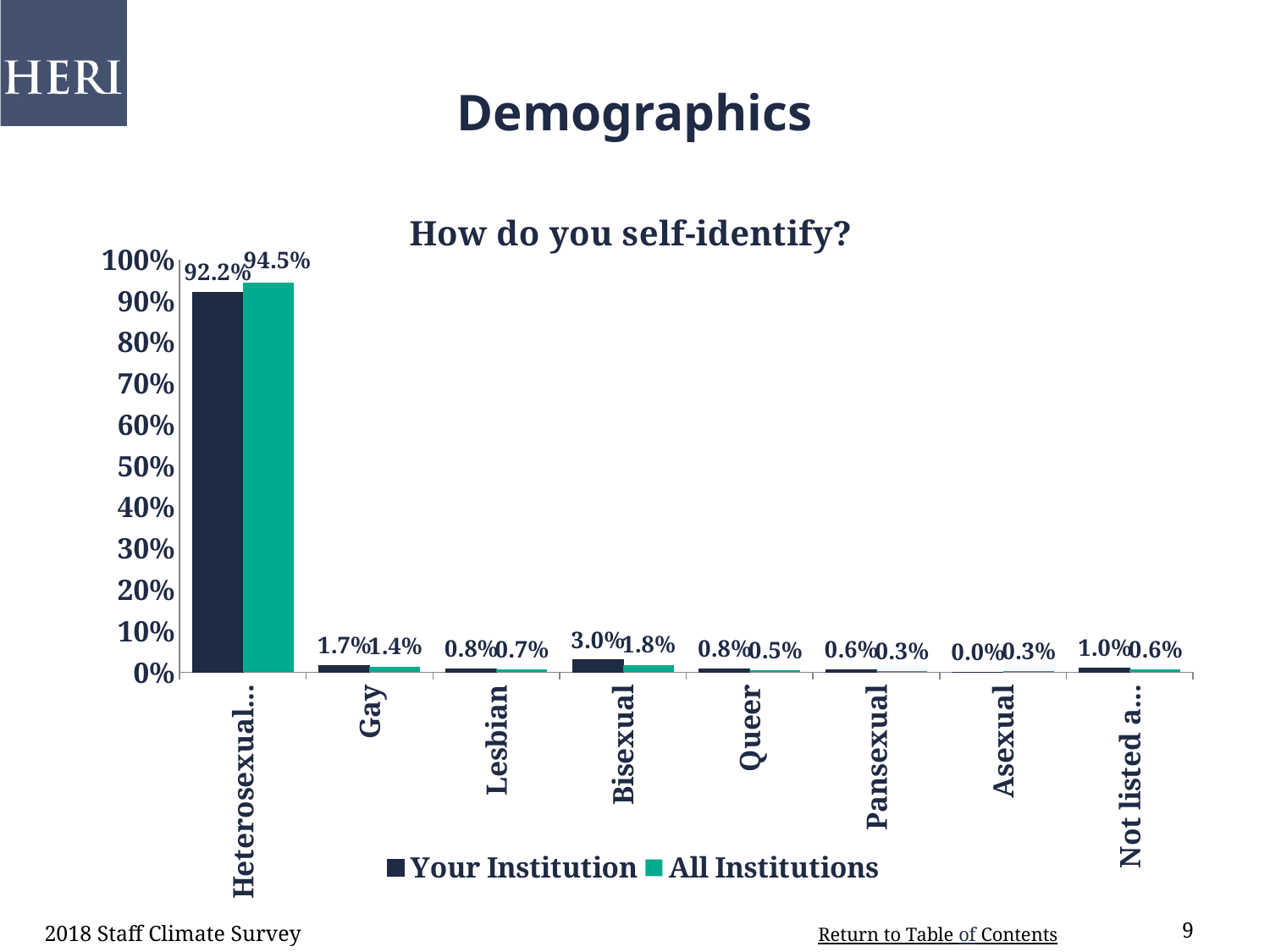
What is the difference between the Your Institution and All Institutions values for Bisexual? 1.2% What is the difference between the All Institutions and Your Institution values for Heterosexual? 2.3% Which category has the lowest value in the Your Institution series? Asexual What is the value for Asexual in the Your Institution series? 0.0% What is the value for Pansexual in the All Institutions series? 0.3% What kind of chart is shown on the slide? Bar chart Which is larger for Queer: the Your Institution value or the All Institutions value? Your Institution What is the value for Bisexual in the All Institutions series? 1.8% What is the value for Gay in the Your Institution series? 1.7% How many categories are shown on the x axis? 8 Which category has the highest value in the All Institutions series? Heterosexual How many series does the legend list? 2